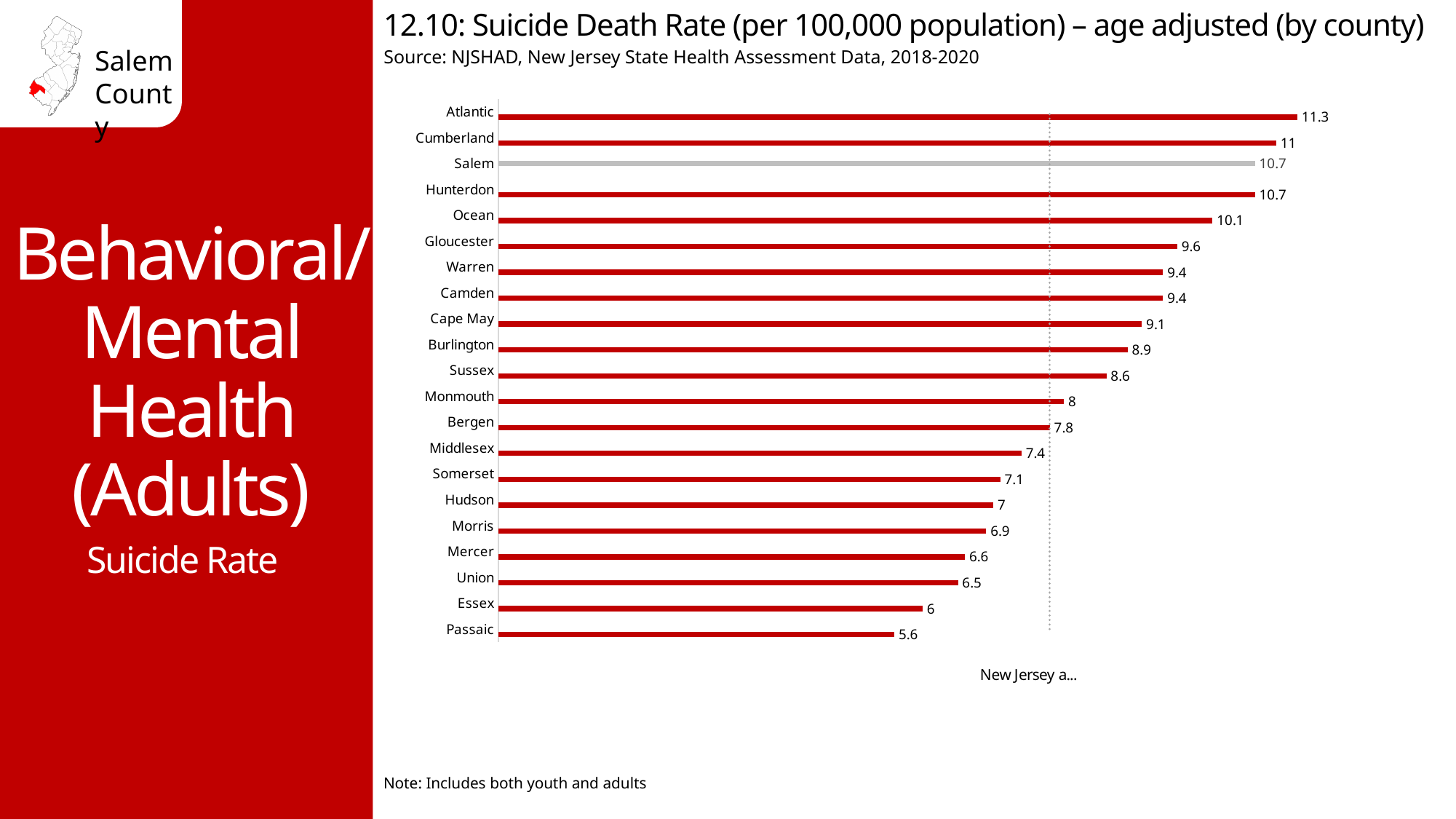
What type of chart is shown on the slide? Bar chart What is the difference between the suicide death rates of Salem and Ocean counties? 0.6 What is the suicide death rate for Atlantic County? 11.3 Which county's bar is shown in grey rather than red? Salem What is the suicide death rate for Salem County? 10.7 What is the suicide death rate for Passaic County? 5.6 Which county has the lowest suicide death rate? Passaic How many counties are shown in the chart? 21 Which county has the highest suicide death rate? Atlantic What is the suicide death rate for Gloucester County? 9.6 Which county has a higher suicide death rate, Cumberland or Bergen? Cumberland What is the difference between the suicide death rates of Atlantic and Passaic counties? 5.7